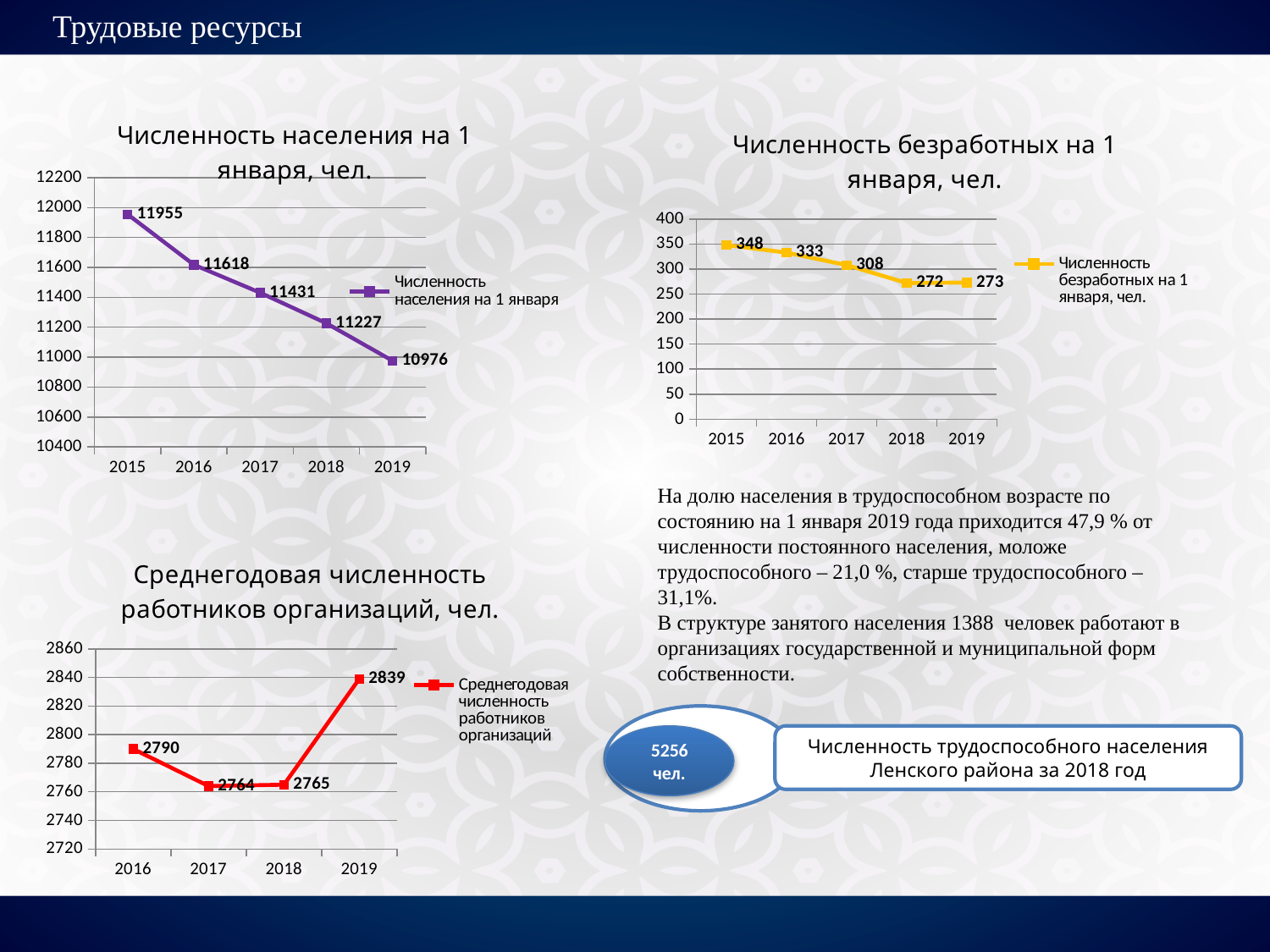
In the chart 'Численность населения на 1 января, чел.', do the values rise or fall from 2015 to 2019? fall In the chart 'Численность населения на 1 января, чел.', what is the difference between the 2015 and 2019 values? 979 In the chart 'Среднегодовая численность работников организаций, чел.', what is the value for 2019? 2839 In the chart 'Численность безработных на 1 января, чел.', which year has the highest value? 2015 In the chart 'Среднегодовая численность работников организаций, чел.', which is larger, the value for 2016 or the value for 2019? 2019 In the chart 'Численность безработных на 1 января, чел.', how many years are plotted? 5 In the chart 'Среднегодовая численность работников организаций, чел.', which year has the lowest value? 2017 In the chart 'Численность населения на 1 января, чел.', what is the value for 2017? 11431 In the chart 'Численность населения на 1 января, чел.', which year has the lowest value? 2019 In the chart 'Численность безработных на 1 января, чел.', what is the difference between the 2015 and 2018 values? 76 In the chart 'Численность безработных на 1 января, чел.', what is the value for 2016? 333 What kind of chart is 'Среднегодовая численность работников организаций, чел.'? line chart